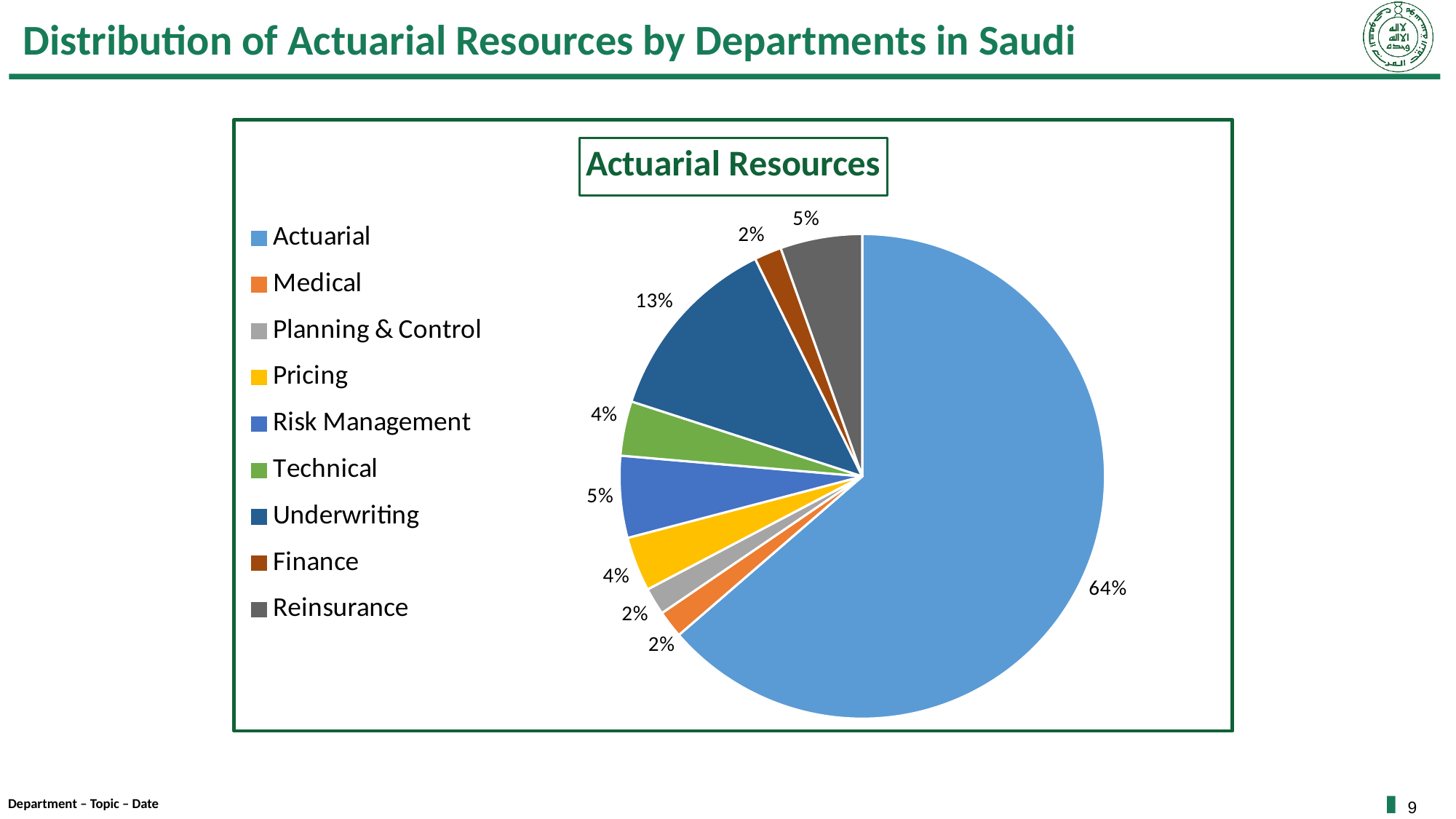
How many departments are shown in the pie chart? 9 Which department has the largest share of actuarial resources? Actuarial What is the value shown for Pricing? 4% What is the value shown for Reinsurance? 5% What is the title of the chart? Actuarial Resources What is the value shown for Risk Management? 5% What share of actuarial resources does the Actuarial department hold? 64% What type of chart is shown on the slide? pie chart What is the difference in percentage points between the Actuarial and Underwriting shares? 51 What colour is the Technical slice in the pie chart? green Which has a larger share, Underwriting or Technical? Underwriting What share of actuarial resources does the Underwriting department hold? 13%